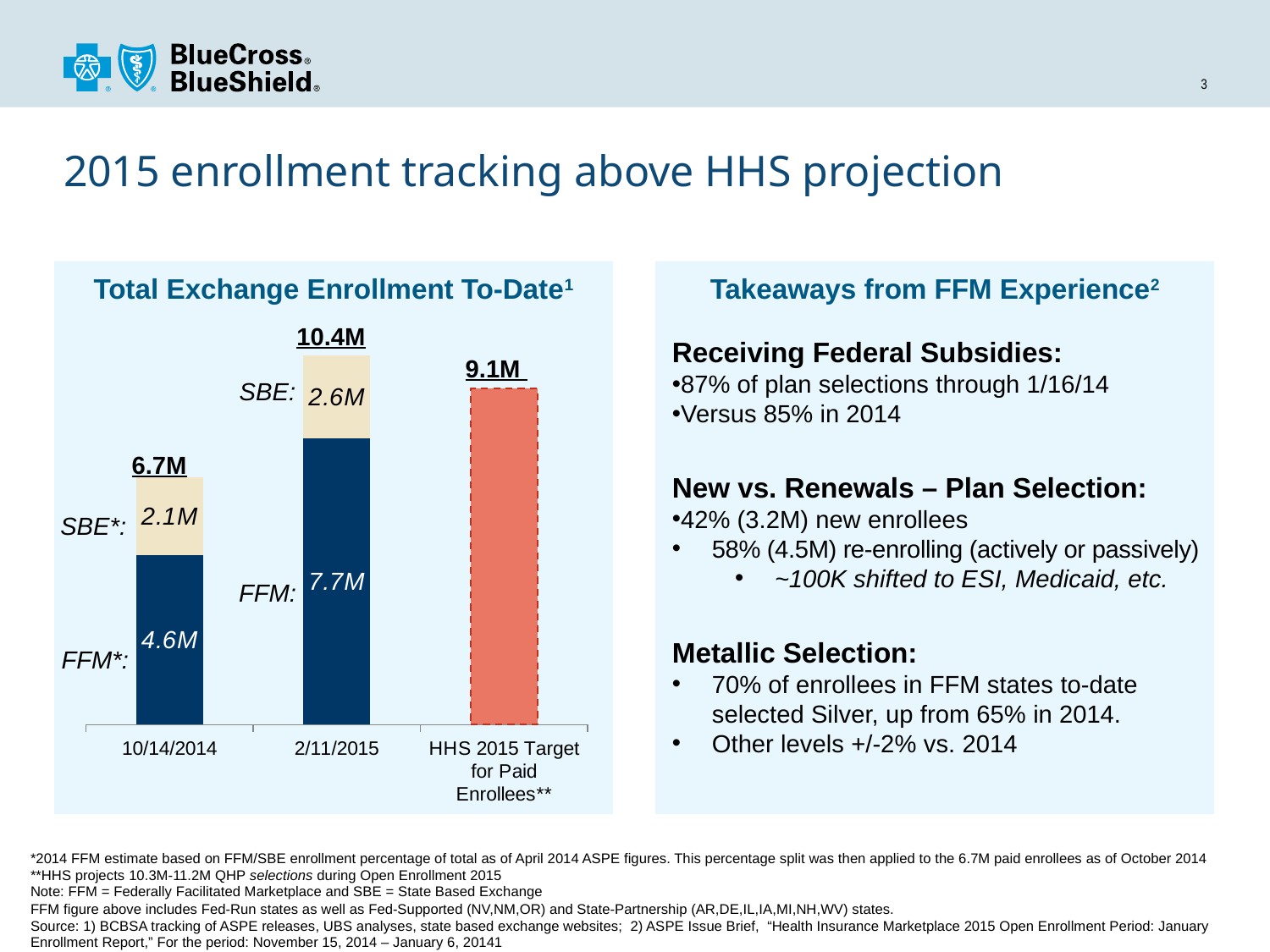
What is the SBE value for 2/11/2015? 2.6M What is the title of the chart on the left of the slide? Total Exchange Enrollment To-Date Which bar has the lowest total value? 10/14/2014 What is the difference between the SBE value for 2/11/2015 and the SBE value for 10/14/2014? 0.5M What is the difference between the FFM value for 2/11/2015 and the FFM value for 10/14/2014? 3.1M How many bars are shown in the chart? 3 What is the total enrollment shown for 2/11/2015? 10.4M Which is larger: the 2/11/2015 total or the HHS 2015 Target for Paid Enrollees? 2/11/2015 total What is the FFM value for 10/14/2014? 4.6M What is the value of the HHS 2015 Target for Paid Enrollees bar? 9.1M Which bar has the highest total value? 2/11/2015 What type of chart is shown under the title "Total Exchange Enrollment To-Date"? Stacked bar chart